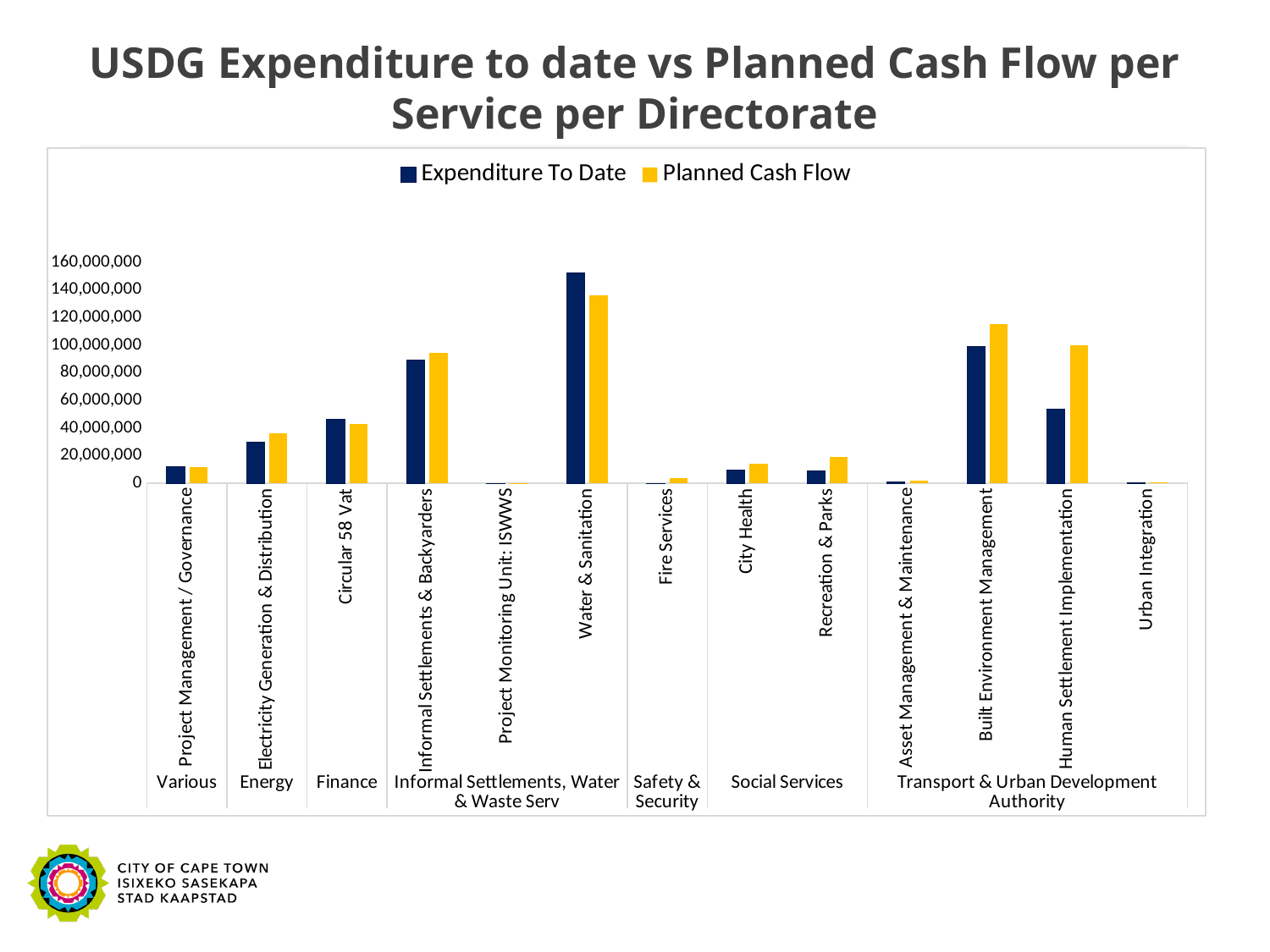
Which service has the highest Expenditure To Date? Water & Sanitation Is the Expenditure To Date for Water & Sanitation greater or less than 140,000,000? greater Is the Expenditure To Date for Informal Settlements & Backyarders greater or less than 80,000,000? greater For Water & Sanitation, which is larger: Expenditure To Date or Planned Cash Flow? Expenditure To Date Is the Planned Cash Flow for Built Environment Management greater or less than 100,000,000? greater How many series does the legend list? 2 Which service has the highest Planned Cash Flow? Water & Sanitation How many services are plotted along the x axis? 13 What colour are the Planned Cash Flow bars? Yellow What kind of chart is shown on the slide? Bar chart For Human Settlement Implementation, which is larger: Expenditure To Date or Planned Cash Flow? Planned Cash Flow